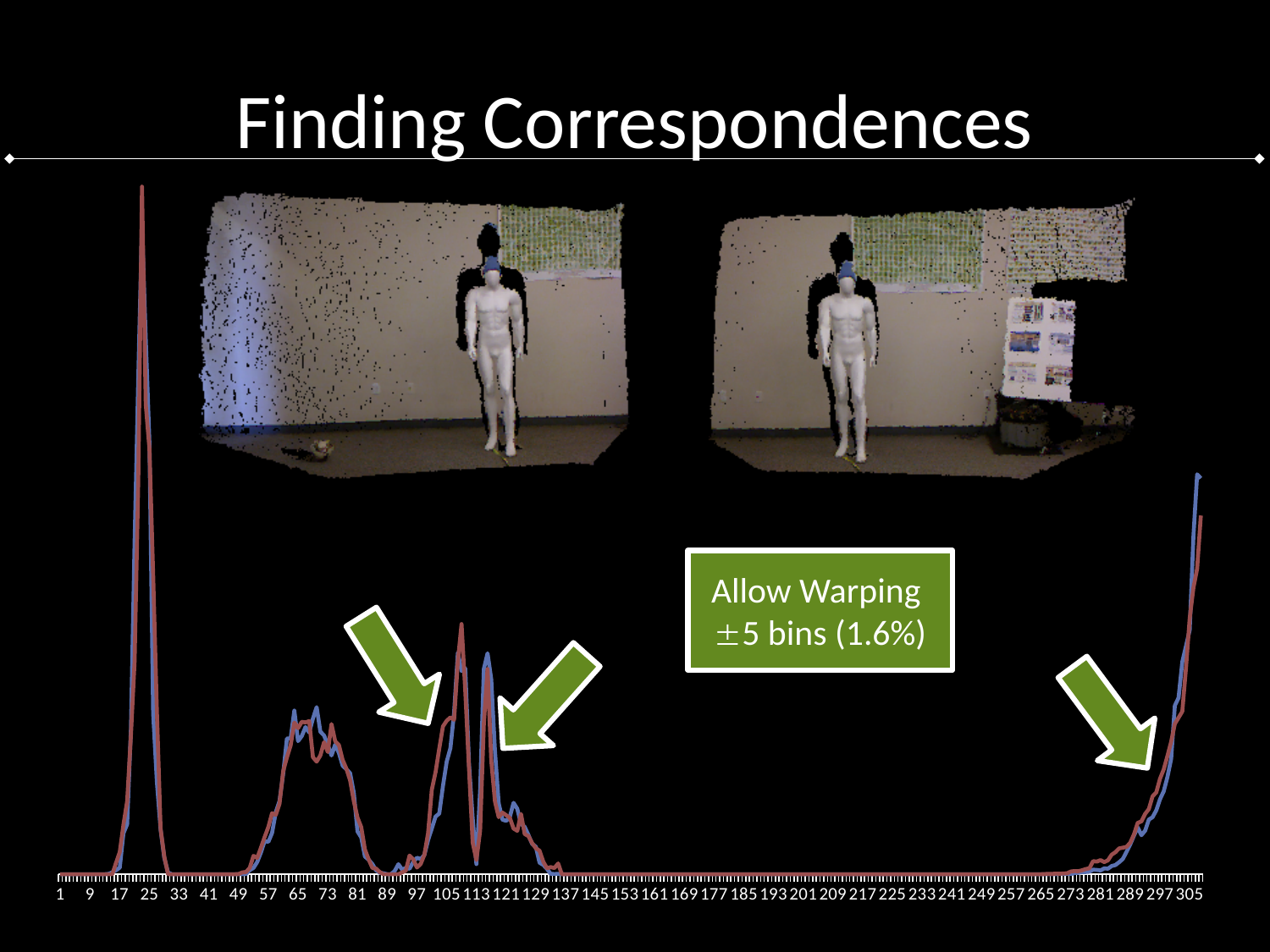
What kind of chart is shown at the bottom of the slide? line chart Do the lines rise or fall between x = 25 and x = 41? fall Which peak is taller, the one near x = 65 or the one near x = 113? the one near x = 113 By what step do the x-axis labels increase? 8 What warping allowance does the green text box on the chart state? ±5 bins (1.6%) What is the last label on the x axis? 305 What is the first label on the x axis? 1 How many lines are plotted on the chart? 2 What colours are the two plotted lines? blue and red Which peak is taller, the one near x = 25 or the one near x = 113? the one near x = 25 Do the lines rise or fall between x = 265 and x = 305? rise